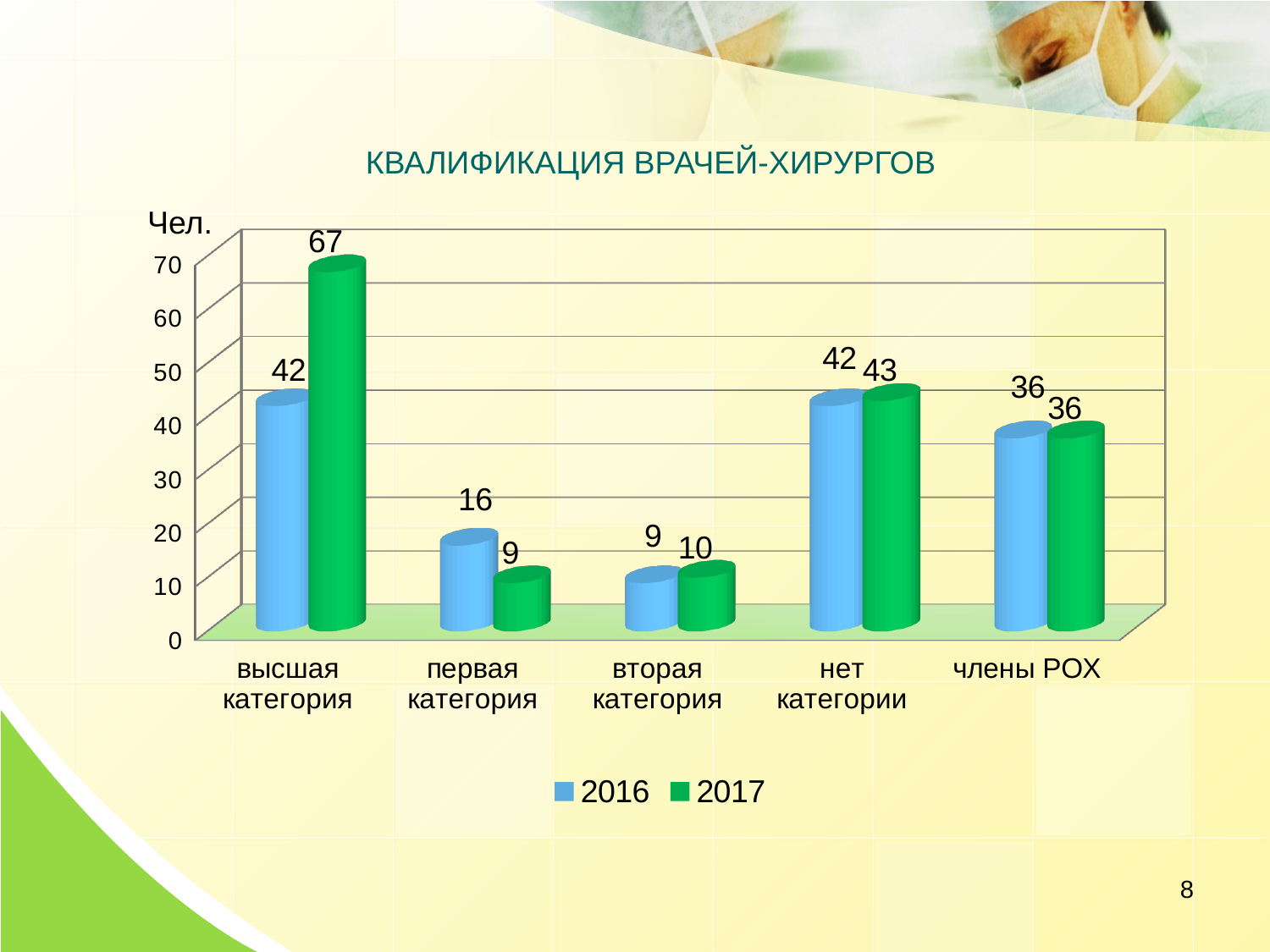
Which category has the lowest value for 2016? вторая категория How many series does the legend list? 2 Which is larger for 'первая категория': the 2016 value or the 2017 value? 2016 What kind of chart is shown on the slide? bar chart How many categories are shown on the x axis? 5 What is the difference between the 2017 and 2016 values for 'высшая категория'? 25 What is the value for 2017 in the 'нет категории' category? 43 Which category has the highest value for 2017? высшая категория What is the title of the chart? КВАЛИФИКАЦИЯ ВРАЧЕЙ-ХИРУРГОВ What is the value for 2016 in the 'первая категория' category? 16 What is the value for 2016 in the 'члены РОХ' category? 36 What is the value for 2017 in the 'высшая категория' category? 67